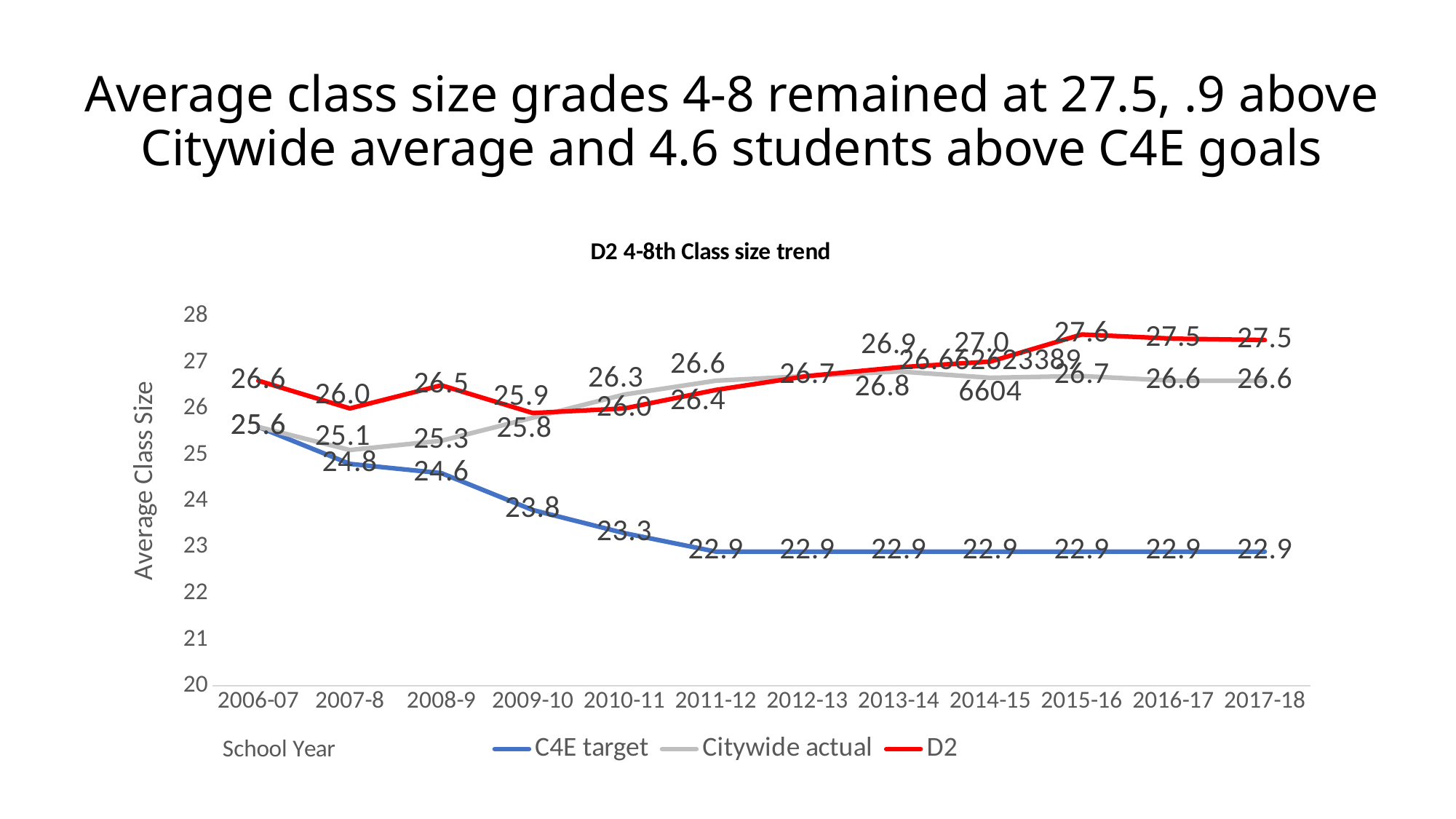
How many series does the legend list? 3 Which is larger in 2011-12, the D2 value or the C4E target value? D2 In which school year is the D2 value lowest? 2009-10 What is the Citywide actual value for 2007-8? 25.1 How many school years are plotted on the x axis? 12 What is the title of the chart? D2 4-8th Class size trend What is the D2 value for 2017-18? 27.5 What is the difference between the D2 value and the C4E target value in 2017-18? 4.6 In which school year does the D2 series reach its highest value? 2015-16 Does the C4E target series rise or fall from 2006-07 to 2011-12? Fall What is the C4E target value for 2006-07? 25.6 What type of chart is shown on the slide? Line chart